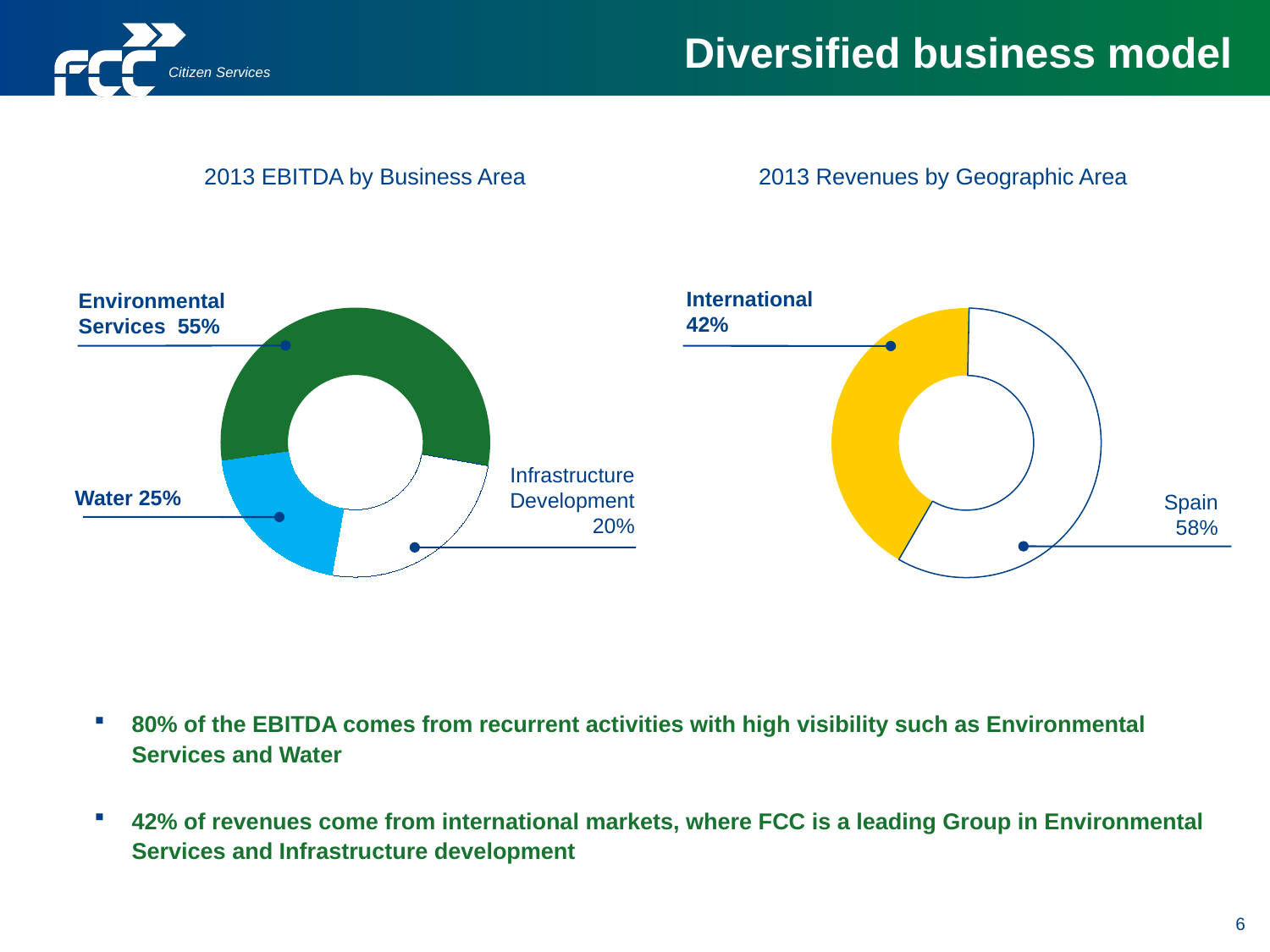
In the '2013 EBITDA by Business Area' chart, what share does Water have? 25% In the '2013 EBITDA by Business Area' chart, how many percentage points larger is Environmental Services than Water? 30 In the '2013 Revenues by Geographic Area' chart, what share does International have? 42% In the '2013 EBITDA by Business Area' chart, how many business areas are shown? 3 In the '2013 EBITDA by Business Area' chart, which business area has the smallest share? Infrastructure Development In the '2013 EBITDA by Business Area' chart, what share does Infrastructure Development have? 20% In the '2013 Revenues by Geographic Area' chart, which geographic area has the larger share, Spain or International? Spain In the '2013 Revenues by Geographic Area' chart, how many percentage points larger is Spain than International? 16 In the '2013 Revenues by Geographic Area' chart, what share does Spain have? 58% What kind of chart is the '2013 Revenues by Geographic Area' chart? Pie chart (doughnut) In the '2013 EBITDA by Business Area' chart, what share does Environmental Services have? 55% In the '2013 EBITDA by Business Area' chart, which business area has the largest share? Environmental Services